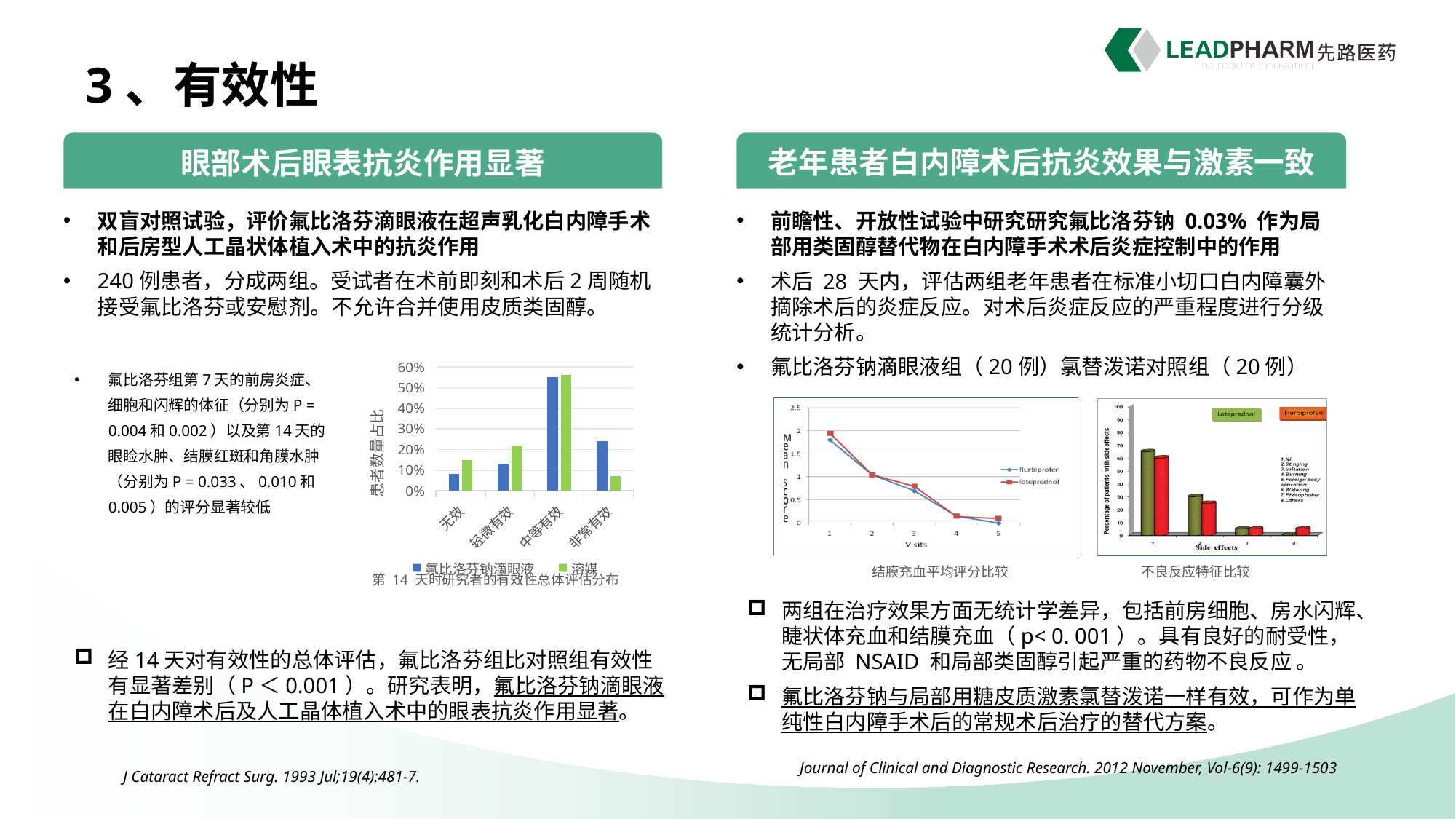
In the chart titled 第14天时研究者的有效性总体评估分布, which category has the highest value for 氟比洛芬钠滴眼液? 中等有效 In the chart titled 第14天时研究者的有效性总体评估分布, is the value for 氟比洛芬钠滴眼液 in 无效 greater or less than 10%? less In the chart titled 第14天时研究者的有效性总体评估分布, which category has the lowest value for 溶媒? 非常有效 In the chart titled 第14天时研究者的有效性总体评估分布, is the value for 氟比洛芬钠滴眼液 in 中等有效 greater or less than 50%? greater What kind of chart is the chart titled 结膜充血平均评分比较? line chart What kind of chart is the chart titled 第14天时研究者的有效性总体评估分布? bar chart In the chart titled 结膜充血平均评分比较, do the mean scores rise or fall as the visit number increases? fall In the chart titled 不良反应特征比较, which side-effect category has the highest bars? 1 How many series does the legend of the chart titled 第14天时研究者的有效性总体评估分布 list? 2 How many categories are shown on the x axis of the chart titled 第14天时研究者的有效性总体评估分布? 4 In the chart titled 第14天时研究者的有效性总体评估分布, which series has the larger value for 非常有效, 氟比洛芬钠滴眼液 or 溶媒? 氟比洛芬钠滴眼液 In the chart titled 第14天时研究者的有效性总体评估分布, which series has the larger value for 无效, 氟比洛芬钠滴眼液 or 溶媒? 溶媒